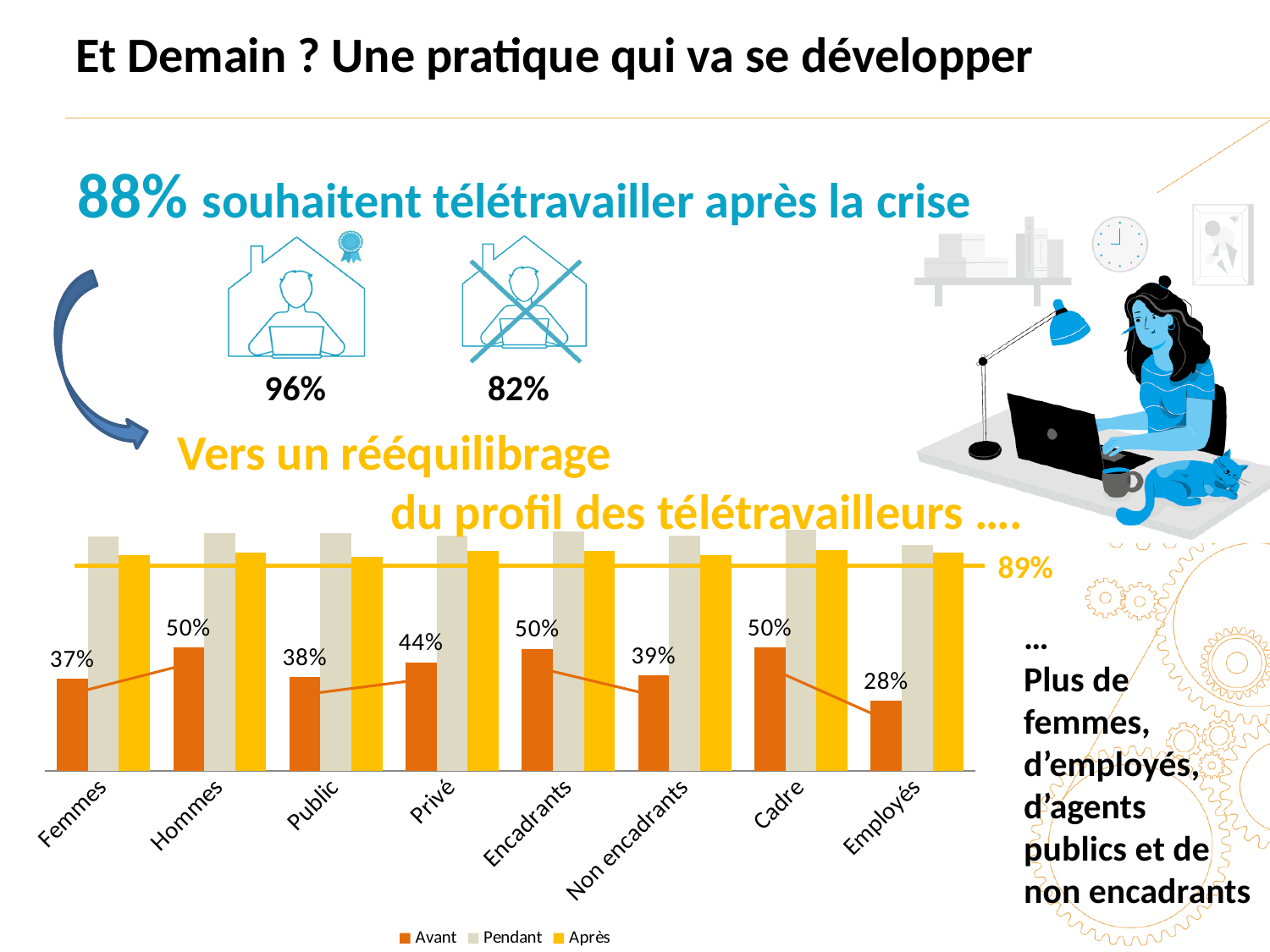
What is the Avant value for Employés? 28% What is the Avant value for Hommes? 50% What kind of chart is shown on the slide? Bar chart Which has the larger Avant value, Public or Privé? Privé What is the difference between the Avant values for Hommes and Femmes? 13% How many categories are shown on the x axis of the chart? 8 What is the Avant value for Non encadrants? 39% What is the Avant value for Privé? 44% What is the difference between the Avant values for Cadre and Employés? 22% How many series does the chart legend list? 3 What is the Avant value for Femmes? 37% Which category has the lowest Avant value? Employés